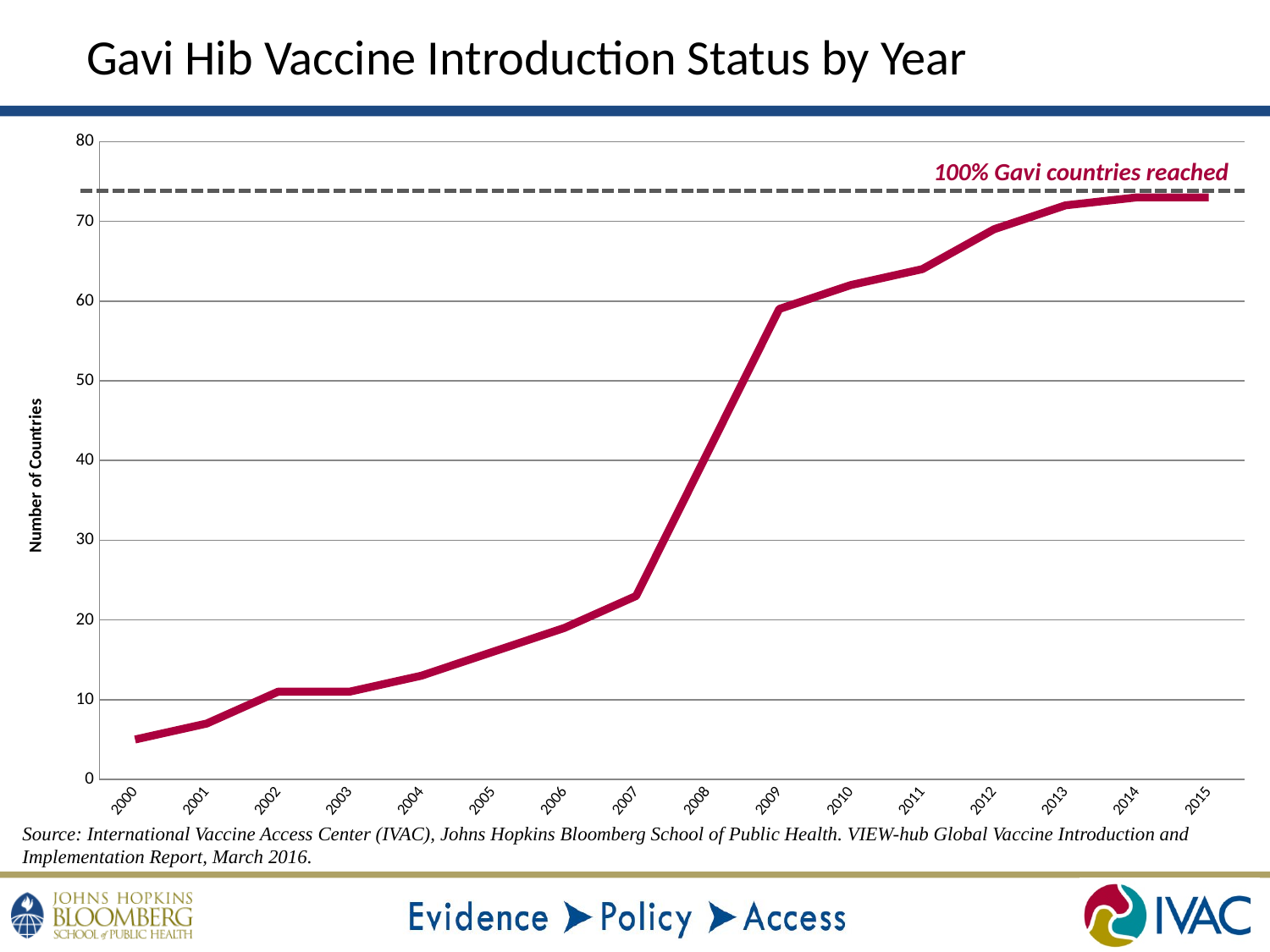
Is the value for 2000 greater or less than 10? less Is the value for 2013 greater or less than 70? greater What is the label on the y axis? Number of Countries What kind of chart is shown on the slide? line chart Is the value for 2005 greater or less than 20? less Which year has the lowest number of countries? 2000 What does the dashed horizontal line near the top of the chart represent? 100% Gavi countries reached Do the values generally rise or fall from 2000 to 2015? rise Which year has the larger value, 2007 or 2009? 2009 How many years are plotted along the x axis? 16